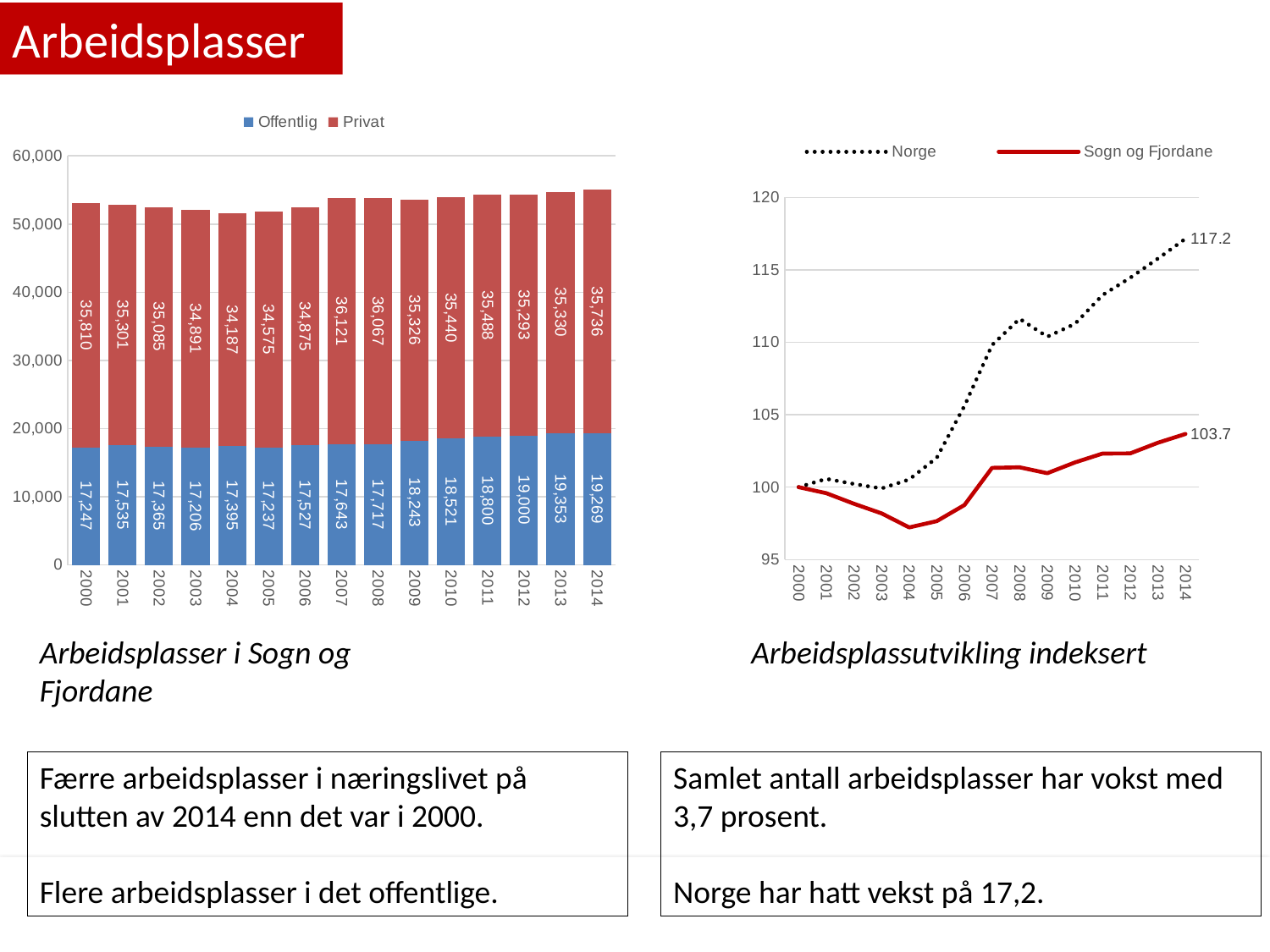
What kind of chart is 'Arbeidsplassutvikling indeksert'? Line chart In the chart 'Arbeidsplassutvikling indeksert', is the value for Sogn og Fjordane in 2004 greater or less than 100? less In the chart 'Arbeidsplasser i Sogn og Fjordane', which year has the lowest Privat value? 2004 In the chart 'Arbeidsplasser i Sogn og Fjordane', what is the Privat value for 2007? 36,121 In the chart 'Arbeidsplasser i Sogn og Fjordane', how many years are shown on the x axis? 15 In the chart 'Arbeidsplassutvikling indeksert', what is the difference between the Norge and Sogn og Fjordane values in 2014? 13.5 In the chart 'Arbeidsplassutvikling indeksert', what is the value for Norge in 2014? 117.2 In the chart 'Arbeidsplasser i Sogn og Fjordane', what is the difference between the Privat value in 2000 and in 2014? 74 In the chart 'Arbeidsplasser i Sogn og Fjordane', what is the total of the stacked bar for 2014? 55,005 In the chart 'Arbeidsplasser i Sogn og Fjordane', what is the Offentlig value for 2014? 19,269 In the chart 'Arbeidsplasser i Sogn og Fjordane', which year has the highest Offentlig value? 2013 In the chart 'Arbeidsplasser i Sogn og Fjordane', how many series does the legend list? 2